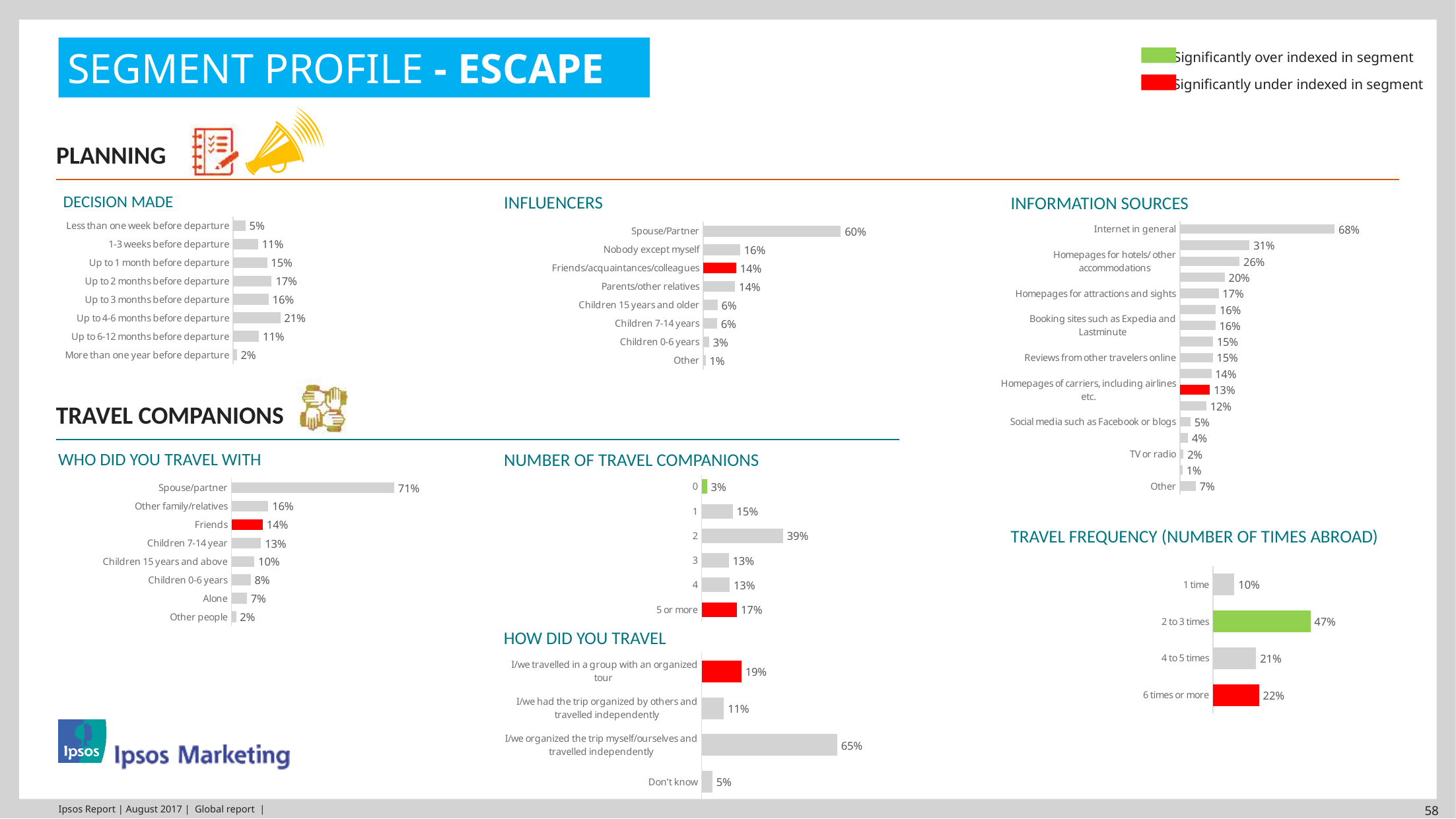
In the INFLUENCERS chart, what is the difference between 'Spouse/Partner' and 'Nobody except myself'? 44% In the NUMBER OF TRAVEL COMPANIONS chart, which category has the highest value? 2 In the DECISION MADE chart, what is the value for 'Up to 4-6 months before departure'? 21% In the TRAVEL FREQUENCY (NUMBER OF TIMES ABROAD) chart, what is the value for '2 to 3 times'? 47% In the INFLUENCERS chart, what is the value for 'Spouse/Partner'? 60% In the INFORMATION SOURCES chart, what is the value for 'TV or radio'? 2% In the HOW DID YOU TRAVEL chart, which is larger: 'I/we travelled in a group with an organized tour' or 'I/we had the trip organized by others and travelled independently'? I/we travelled in a group with an organized tour In the INFORMATION SOURCES chart, which category has the highest value? Internet in general In the DECISION MADE chart, which category has the lowest value? More than one year before departure In the TRAVEL FREQUENCY (NUMBER OF TIMES ABROAD) chart, which bar is coloured green? 2 to 3 times In the WHO DID YOU TRAVEL WITH chart, what is the value for 'Friends'? 14% In the WHO DID YOU TRAVEL WITH chart, how many categories are shown? 8